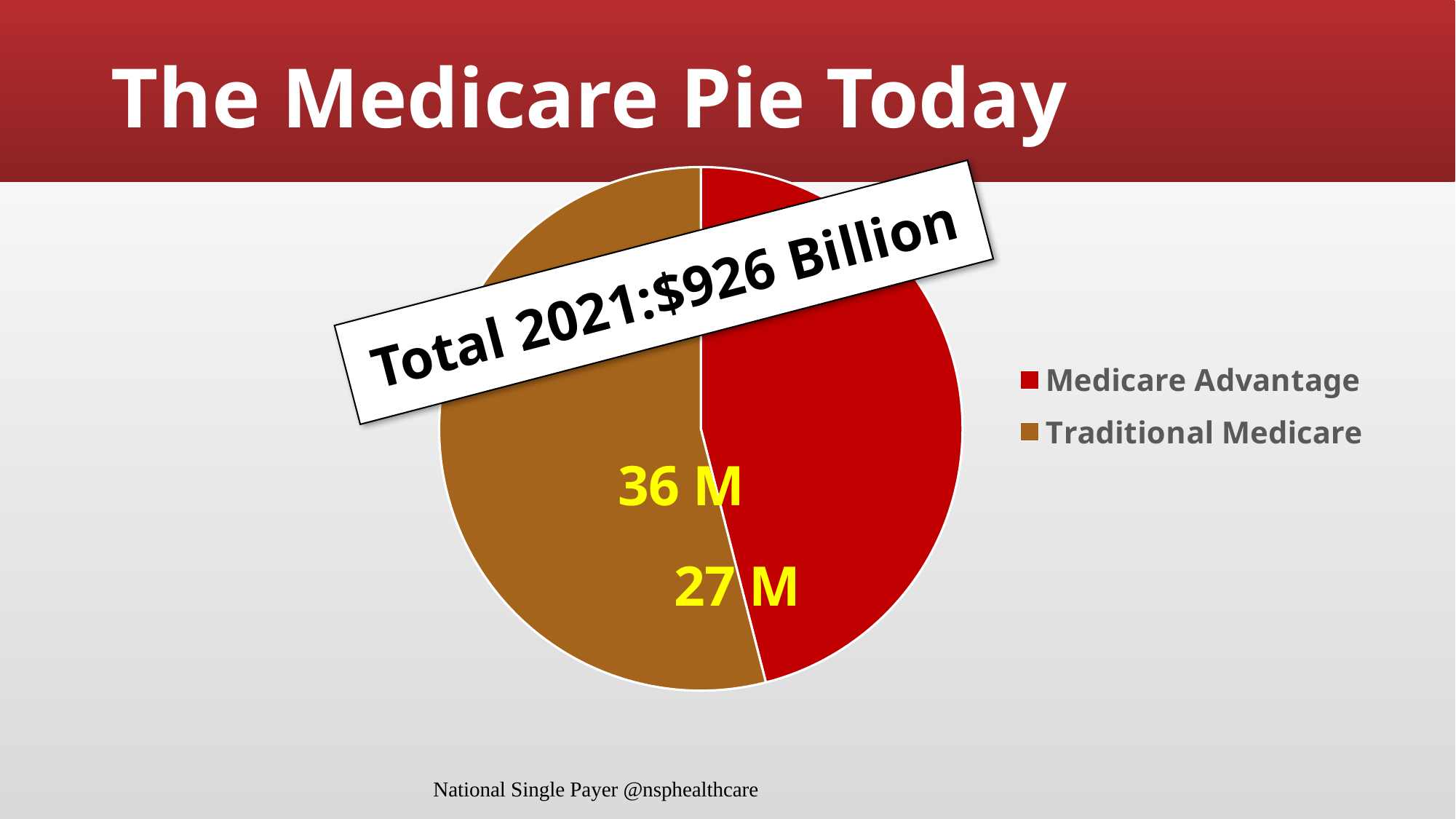
Which slice of the pie chart is the largest? Traditional Medicare How many slices does the pie chart have? 2 What is the combined value of the two slices in the pie chart? 63 M How many entries does the legend of the pie chart list? 2 What kind of chart is shown on the slide? pie chart Which is larger, Traditional Medicare or Medicare Advantage? Traditional Medicare What value is labelled on the Traditional Medicare slice? 36 M What colour represents Medicare Advantage in the pie chart? red What is the title of the slide containing the pie chart? The Medicare Pie Today What is the difference between the Traditional Medicare value and the Medicare Advantage value? 9 M Which slice of the pie chart is the smallest? Medicare Advantage What value is labelled on the Medicare Advantage slice? 27 M